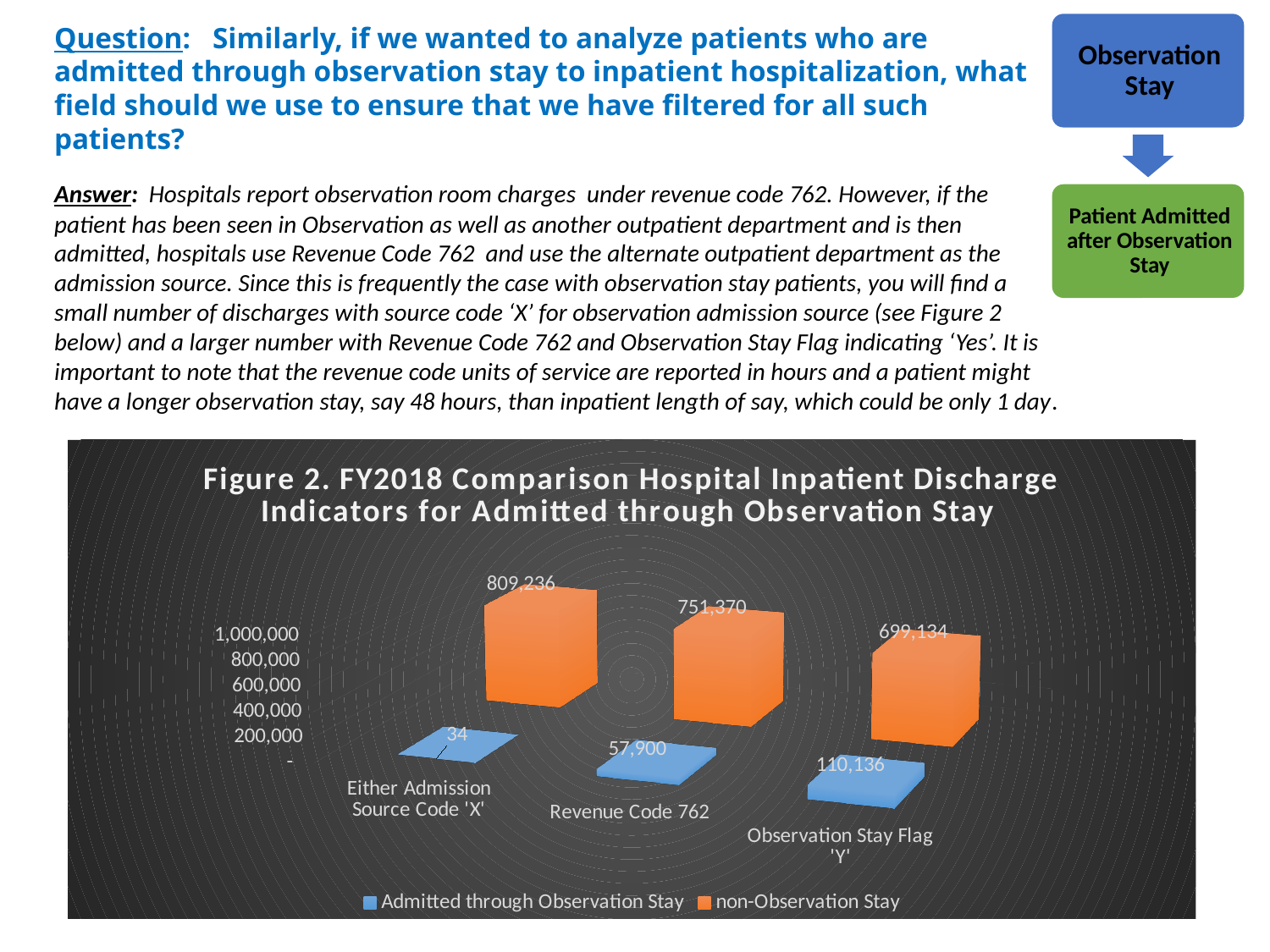
What is the value for 'non-Observation Stay' in the Observation Stay Flag 'Y' category? 699,134 How many categories are shown on the x axis of the chart? 3 Which category has the lowest value for the 'non-Observation Stay' series? Observation Stay Flag 'Y' What is the value for 'Admitted through Observation Stay' in the Revenue Code 762 category? 57,900 What kind of chart is shown on the slide? Bar chart Which category has the highest value for the 'Admitted through Observation Stay' series? Observation Stay Flag 'Y' Which is larger: the 'Admitted through Observation Stay' value for Revenue Code 762 or for Observation Stay Flag 'Y'? Observation Stay Flag 'Y' How many series does the chart legend list? 2 What is the value for 'Admitted through Observation Stay' in the Observation Stay Flag 'Y' category? 110,136 Do the 'non-Observation Stay' values rise or fall from left to right across the categories? Fall What is the value for 'non-Observation Stay' in the Either Admission Source Code 'X' category? 809,236 What is the difference between the 'non-Observation Stay' values for Either Admission Source Code 'X' and Revenue Code 762? 57,866